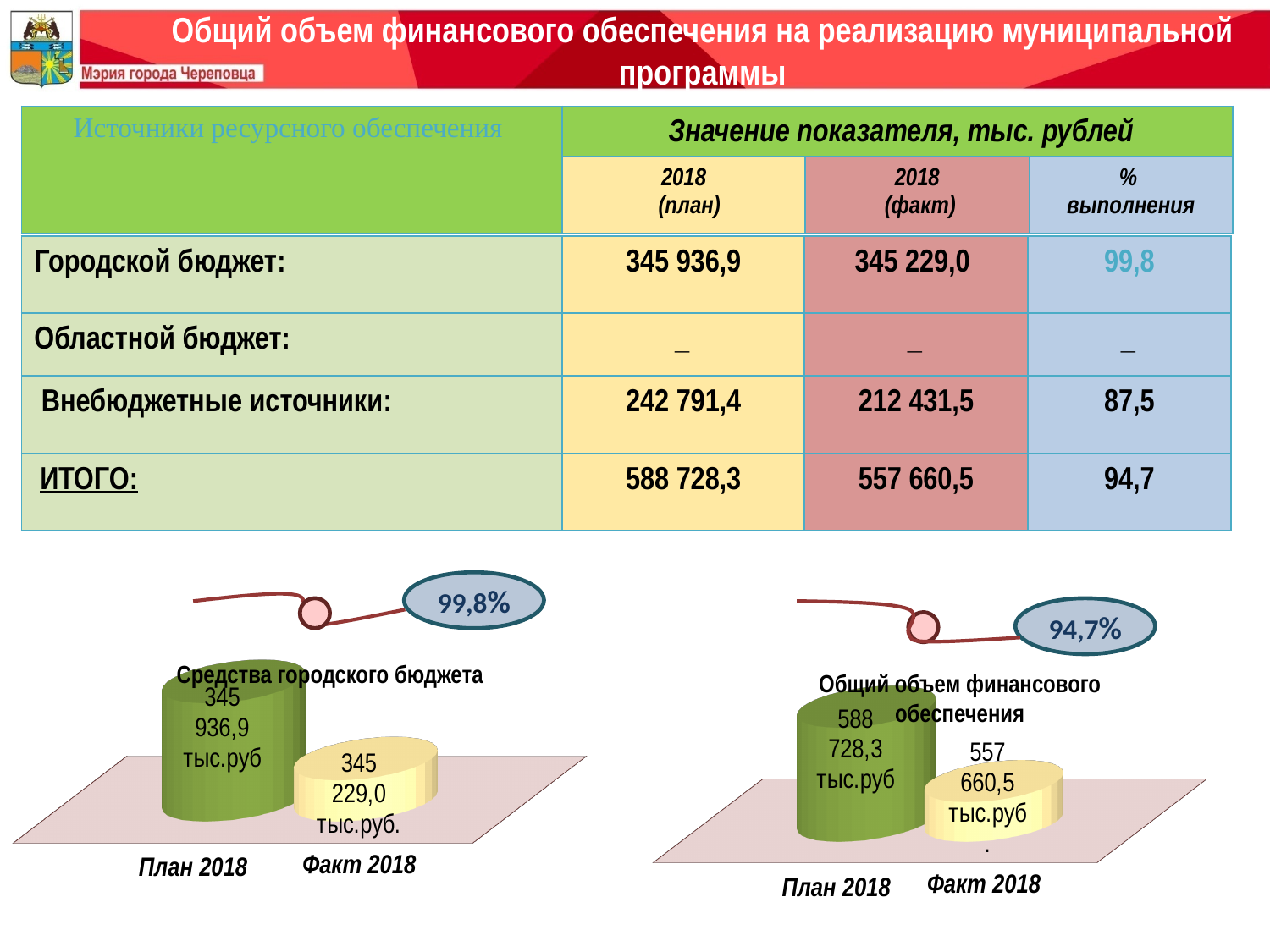
What percentage is shown in the callout above the right chart 'Общий объем финансового обеспечения'? 94,7% How many categories are shown in the left chart 'Средства городского бюджета'? 2 In the left chart 'Средства городского бюджета', what is the value for Факт 2018? 345 229,0 тыс.руб. In the right chart 'Общий объем финансового обеспечения', what is the difference between План 2018 and Факт 2018? 31 067,8 тыс.руб What percentage is shown in the callout above the left chart 'Средства городского бюджета'? 99,8% In the left chart 'Средства городского бюджета', which category has the higher value, План 2018 or Факт 2018? План 2018 In the left chart 'Средства городского бюджета', what is the value for План 2018? 345 936,9 тыс.руб In the right chart 'Общий объем финансового обеспечения', which category has the lower value? Факт 2018 In the left chart 'Средства городского бюджета', what is the difference between План 2018 and Факт 2018? 707,9 тыс.руб In the right chart 'Общий объем финансового обеспечения', what is the value for Факт 2018? 557 660,5 тыс.руб What type of chart is the right chart 'Общий объем финансового обеспечения'? Bar chart In the right chart 'Общий объем финансового обеспечения', what is the value for План 2018? 588 728,3 тыс.руб